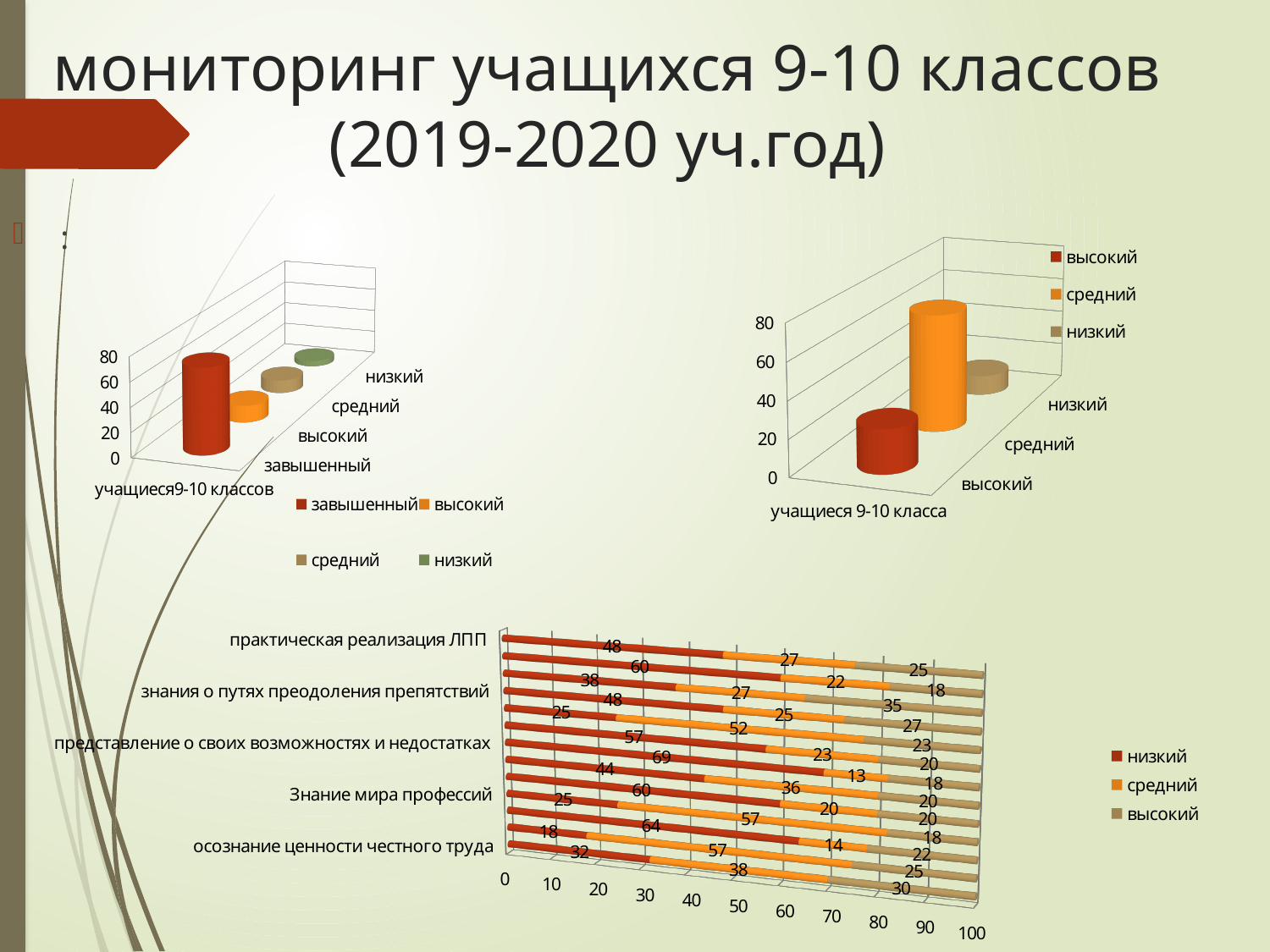
In the top-right chart, which is larger, the value for высокий or the value for низкий? высокий In the top-left chart, which category has the highest value? завышенный In the top-left chart, is the value for завышенный greater or less than 40? greater How many series does the legend of the top-left chart list? 4 In the top-right chart, which category has the highest value? средний How many series does the legend of the bottom chart list? 3 In the top-right chart, is the value for средний greater or less than 40? greater What kind of chart is the bottom chart on the slide? bar chart In the top-right chart, is the value for высокий greater or less than 40? less How many series does the legend of the top-right chart list? 3 What are the legend entries of the bottom chart? низкий, средний, высокий In the top-right chart, which category has the lowest value? низкий